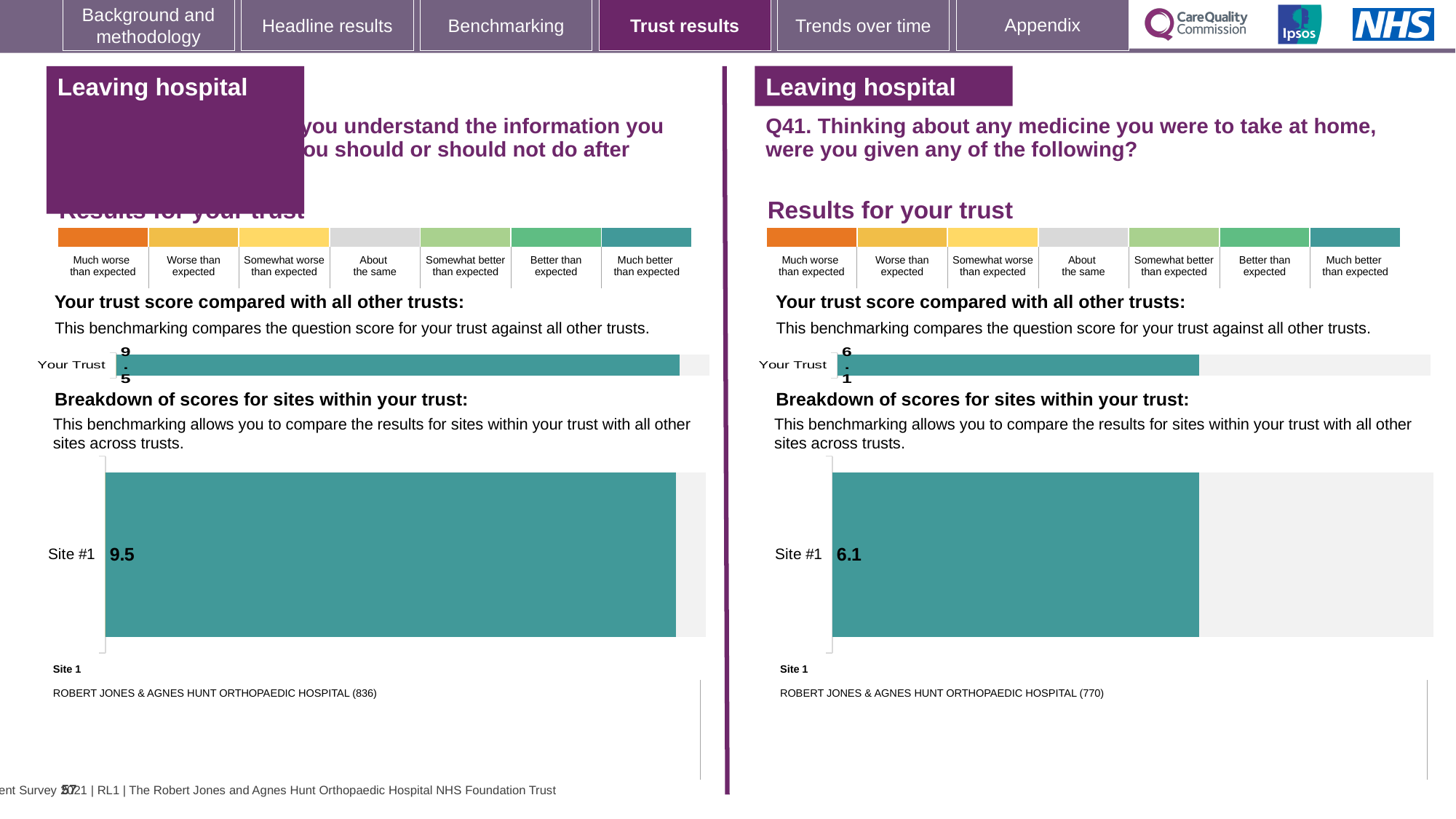
Which Site #1 score is larger: the one on the left half of the slide or the one on the right half (Q41)? The left half (9.5) On the left half of the slide, what is the value shown for 'Your Trust' in the trust score comparison bar? 9.5 What kind of chart is used to show the Site #1 score on the right half of the slide (Q41)? Bar chart On the left half of the slide, what is the score shown for Site #1 in the breakdown of scores for sites within your trust? 9.5 How many sites are shown in the breakdown of scores chart on the right half of the slide (Q41)? 1 What is the difference between the Site #1 score on the left half of the slide and the Site #1 score on the right half (Q41)? 3.4 On the left half of the slide, what is the name of Site 1 listed below the chart? ROBERT JONES & AGNES HUNT ORTHOPAEDIC HOSPITAL (836) On the right half of the slide (Q41), what is the value shown for 'Your Trust' in the trust score comparison bar? 6.1 On the right half of the slide (Q41), what is the score shown for Site #1 in the breakdown of scores for sites within your trust? 6.1 On the right half of the slide (Q41), what is the name of Site 1 listed below the chart? ROBERT JONES & AGNES HUNT ORTHOPAEDIC HOSPITAL (770) On the right half of the slide (Q41), is the Site #1 score greater or less than the 'Your Trust' score on the left half of the slide? less How many sites are shown in the breakdown of scores chart on the left half of the slide? 1